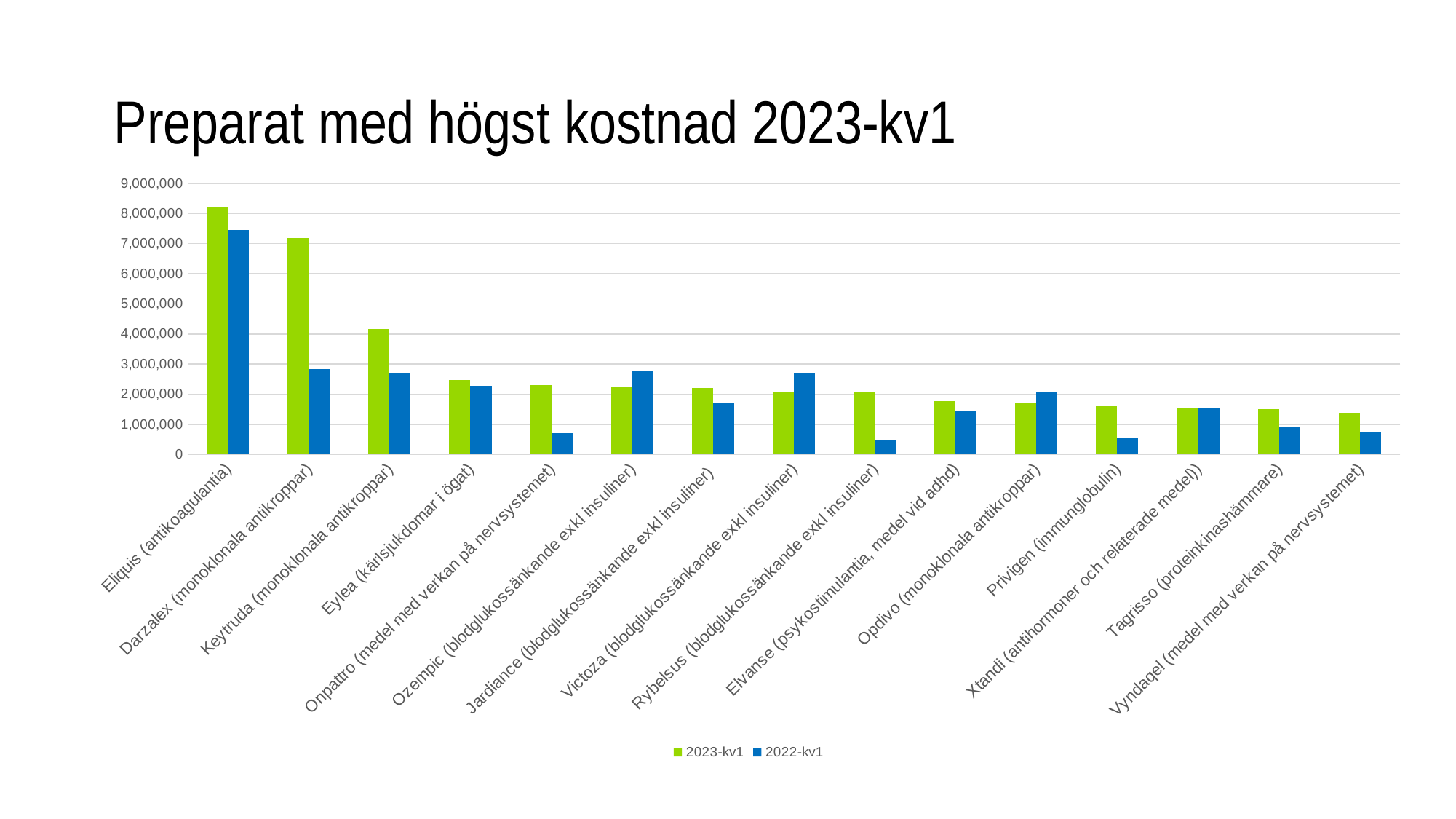
For Onpattro (medel med verkan på nervsystemet), which series has the larger value, 2023-kv1 or 2022-kv1? 2023-kv1 Is the 2022-kv1 value for Jardiance (blodglukossänkande exkl insuliner) greater or less than 2,000,000? less Which preparation has the highest 2022-kv1 value? Eliquis (antikoagulantia) Is the 2023-kv1 value for Keytruda (monoklonala antikroppar) greater or less than 4,000,000? greater How many preparations (categories) are shown on the x axis? 15 Which preparation has the highest 2023-kv1 value? Eliquis (antikoagulantia) For Ozempic (blodglukossänkande exkl insuliner), which series has the larger value, 2023-kv1 or 2022-kv1? 2022-kv1 Is the 2023-kv1 value for Eliquis (antikoagulantia) greater or less than 8,000,000? greater How many series does the legend list? 2 Do the 2023-kv1 values rise or fall from left to right along the x axis? fall What kind of chart is shown on the slide? Bar chart